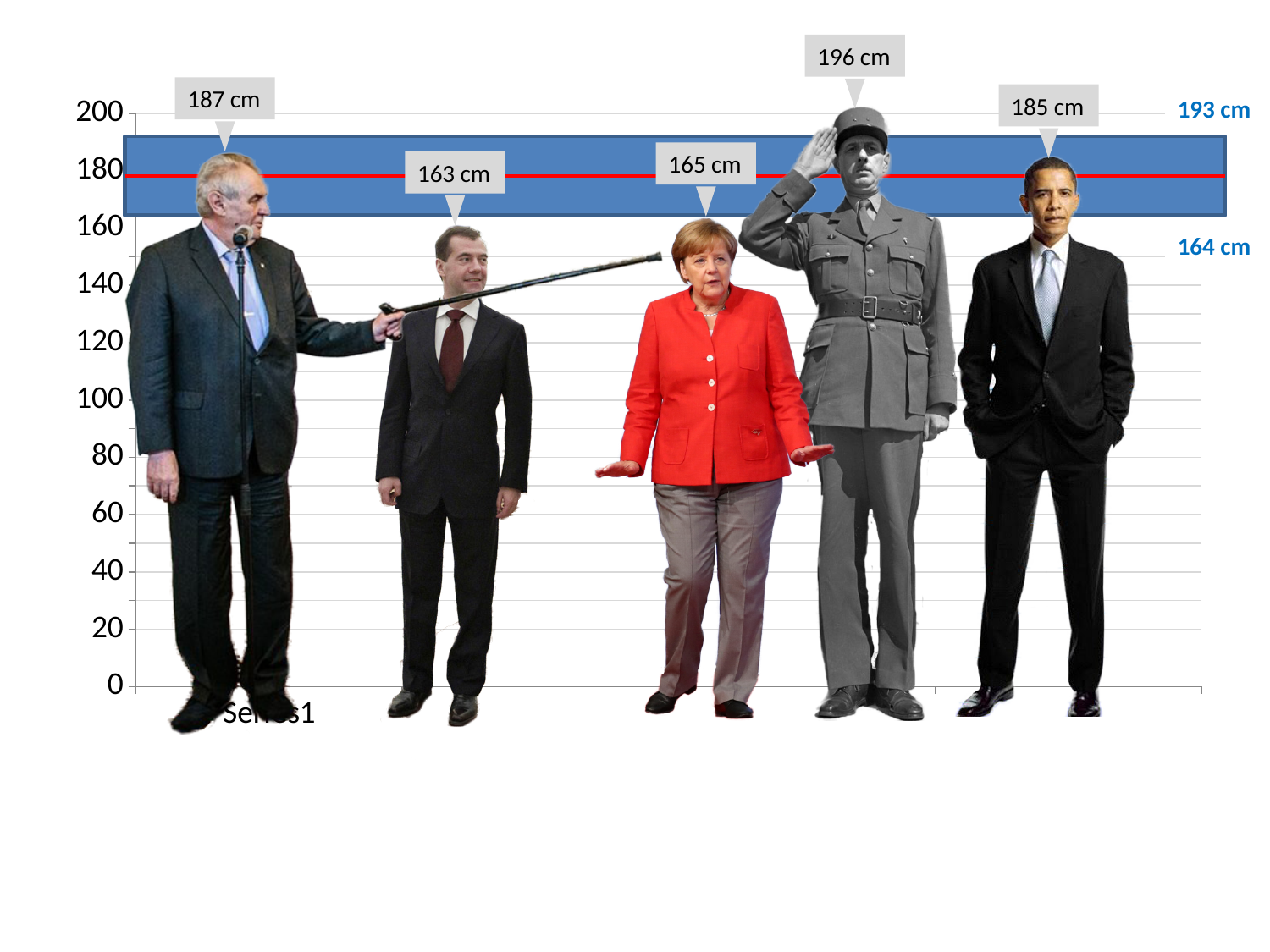
What is the difference between the tallest labelled height (196 cm) and the shortest labelled height (163 cm)? 33 cm What is the height label shown above the second figure from the left? 163 cm What is the height label shown above the leftmost figure? 187 cm Which figure has the smallest labelled height? The second figure from the left (163 cm) What is the height label shown above the middle figure (third from the left)? 165 cm Which figure has the greatest labelled height? The fourth figure from the left (196 cm) How many figures (data points) are shown on the chart? 5 What is the maximum value shown on the vertical axis? 200 Which is taller according to the labels: the leftmost figure or the rightmost figure? The leftmost figure (187 cm) What is the height label shown above the fourth figure from the left? 196 cm What is the height label shown above the rightmost figure? 185 cm What are the two values printed in blue at the right edge of the shaded band? 193 cm and 164 cm